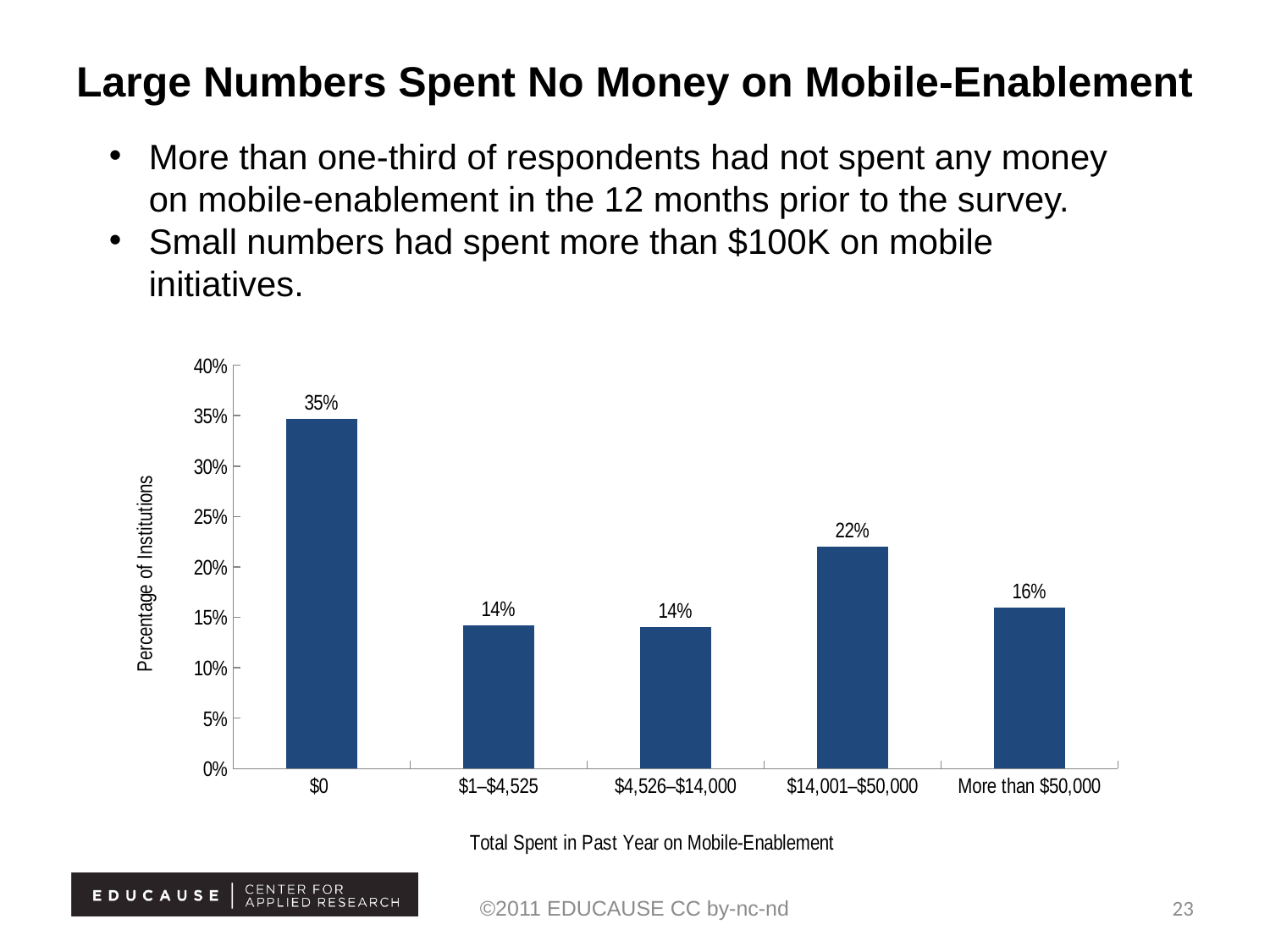
Which is larger: the percentage for $14,001–$50,000 or the percentage for More than $50,000? $14,001–$50,000 Is the value for the $0 category greater or less than 30%? greater How many spending categories are shown on the x axis? 5 What is the difference in percentage points between the $0 category and the $14,001–$50,000 category? 13 What percentage of institutions spent $1–$4,525 on mobile-enablement? 14% What is the label of the x axis? Total Spent in Past Year on Mobile-Enablement What percentage of institutions spent more than $50,000 on mobile-enablement? 16% What kind of chart is shown on the slide? bar chart Which spending category has the highest percentage of institutions? $0 What is the label of the y axis? Percentage of Institutions What percentage of institutions spent $14,001–$50,000 on mobile-enablement? 22% What percentage of institutions spent $0 on mobile-enablement in the past year? 35%